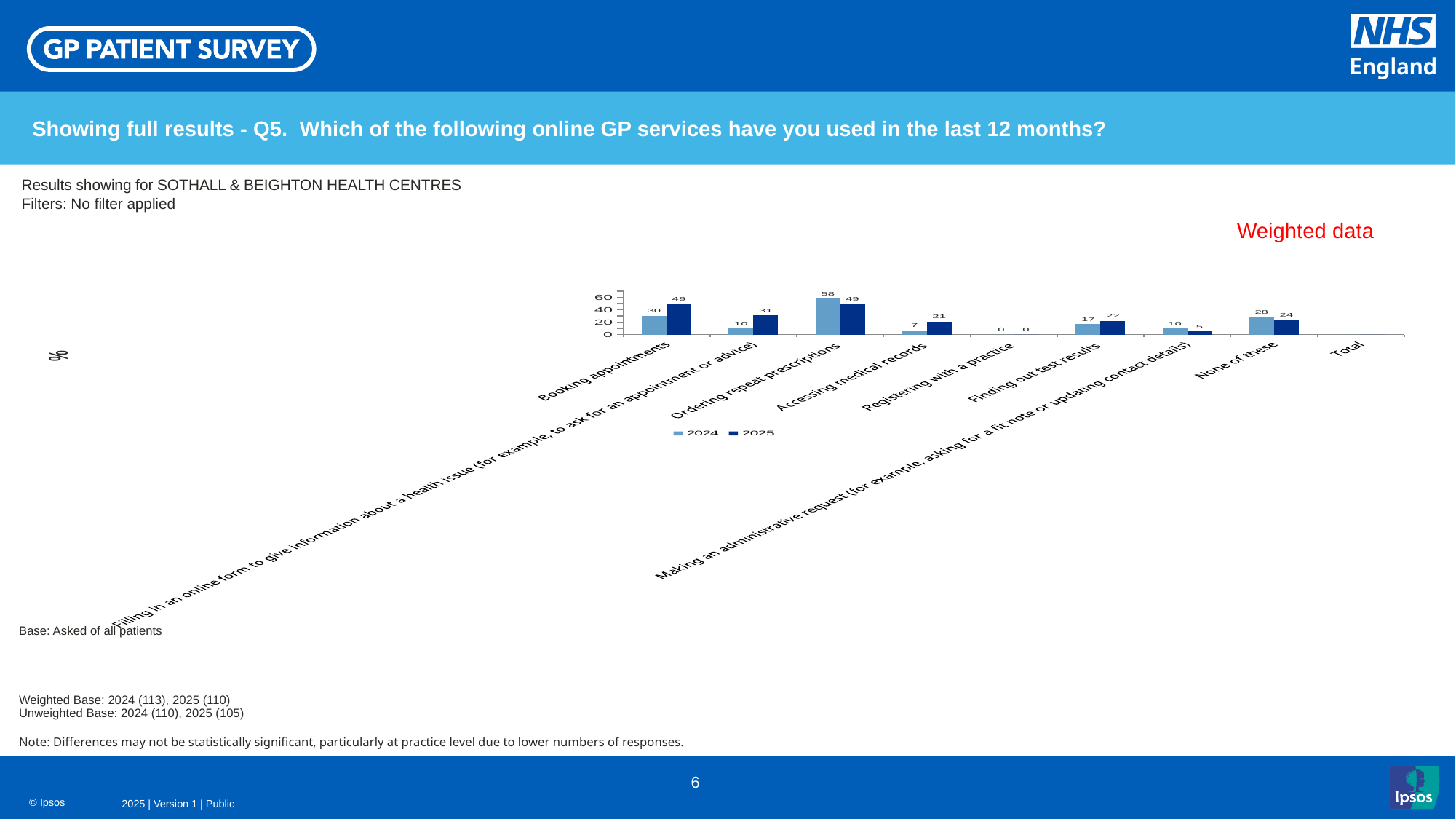
What is the difference between the 2025 and 2024 values for Booking appointments? 19 What kind of chart is shown on the slide? Bar chart Which series is shown in the darker blue colour? 2025 What is the 2025 value for Accessing medical records? 21 Which category has the highest 2024 value? Ordering repeat prescriptions Which category has the lowest 2025 value? Registering with a practice How many series does the legend list? 2 Which is larger for Finding out test results, the 2024 value or the 2025 value? 2025 What is the 2025 value for Booking appointments? 49 What is the 2024 value for Ordering repeat prescriptions? 58 Is the 2024 value for Ordering repeat prescriptions greater or less than 40? greater What is the 2024 value for None of these? 28